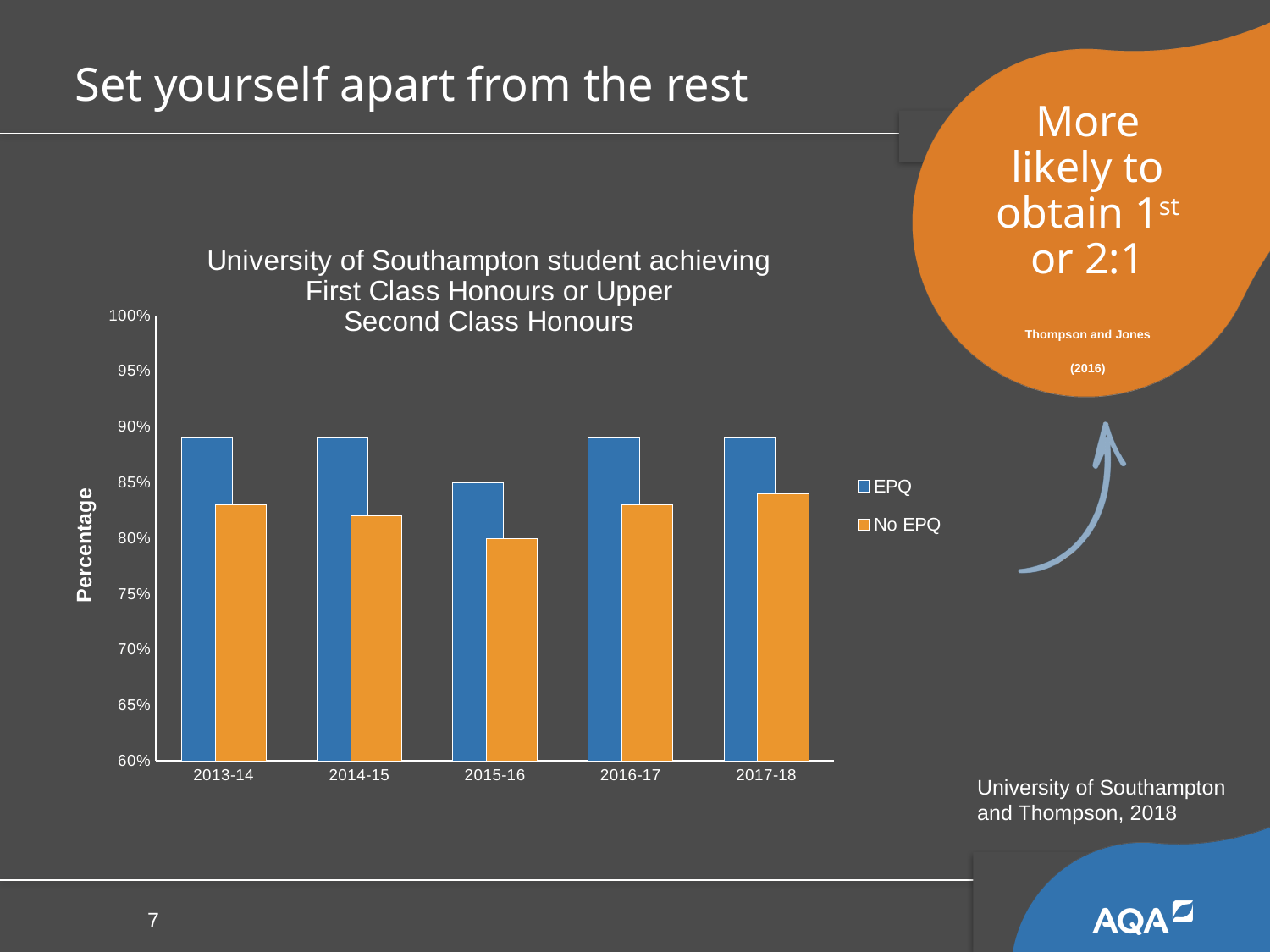
What kind of chart is shown on the slide? bar chart In which year is the No EPQ value lowest? 2015-16 Which series is shown in orange in the chart? No EPQ In which year is the EPQ value lowest? 2015-16 In 2016-17, which is larger: the EPQ value or the No EPQ value? EPQ Is the No EPQ value for 2015-16 greater or less than 85%? less How many academic years are shown on the x axis of the chart? 5 Is the No EPQ value for 2014-15 greater or less than 85%? less What is the label on the vertical axis of the chart? Percentage Is the EPQ value for 2015-16 greater or less than 80%? greater How many series does the chart legend list? 2